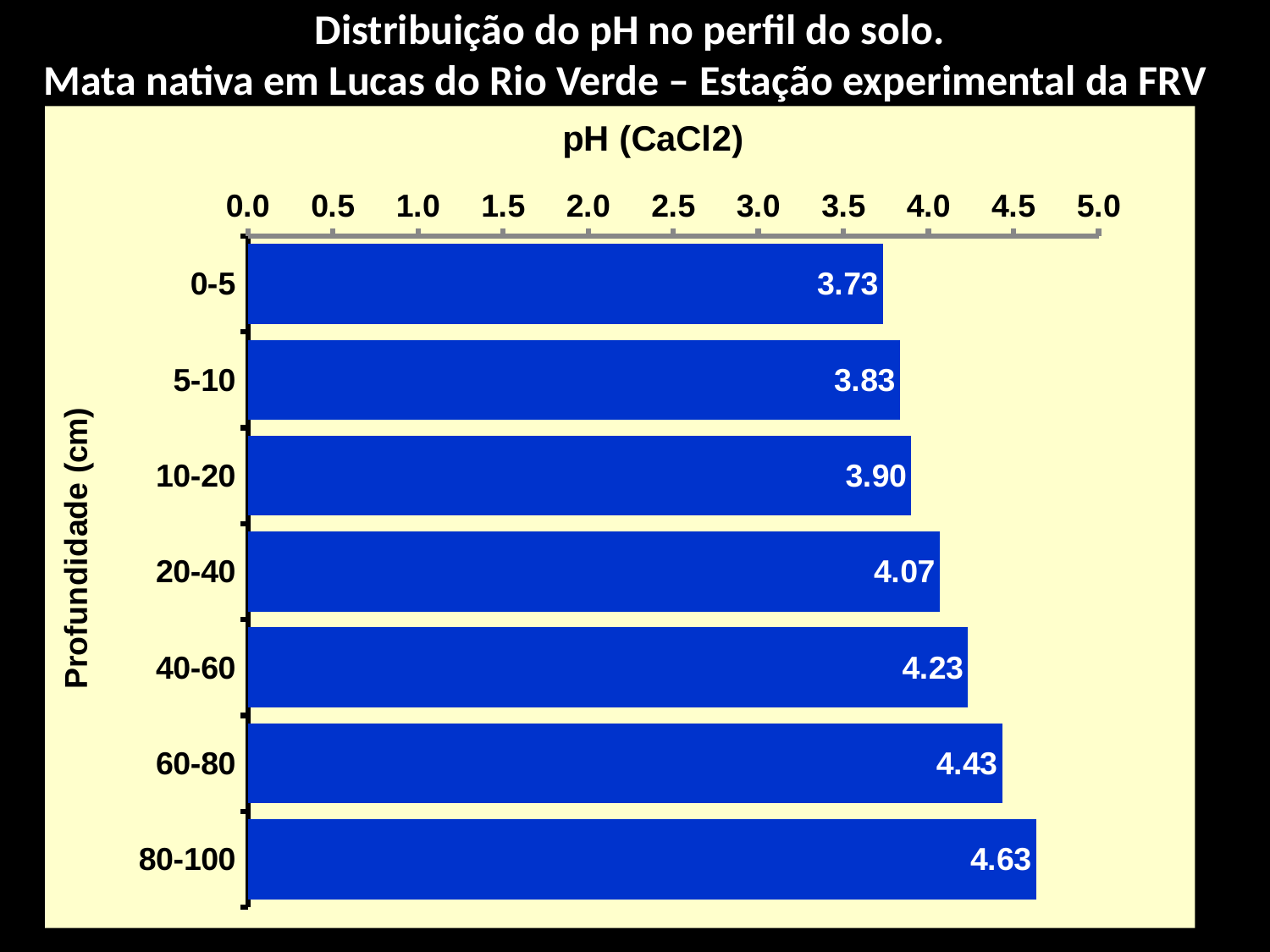
What is the label of the vertical axis of the chart? Profundidade (cm) What is the pH (CaCl2) value for the 20-40 cm depth? 4.07 Which depth has the lowest pH (CaCl2) value? 0-5 What is the pH (CaCl2) value for the 80-100 cm depth? 4.63 Which has a higher pH value, the 10-20 cm depth or the 40-60 cm depth? 40-60 What is the difference in pH between the 80-100 cm depth and the 0-5 cm depth? 0.90 What is the pH (CaCl2) value for the 0-5 cm depth? 3.73 How many depth categories are shown in the chart? 7 Is the pH value for the 5-10 cm depth greater or less than 4.0? less What is the difference in pH between the 60-80 cm depth and the 40-60 cm depth? 0.20 Which depth has the highest pH (CaCl2) value? 80-100 What kind of chart is shown on the slide? Bar chart